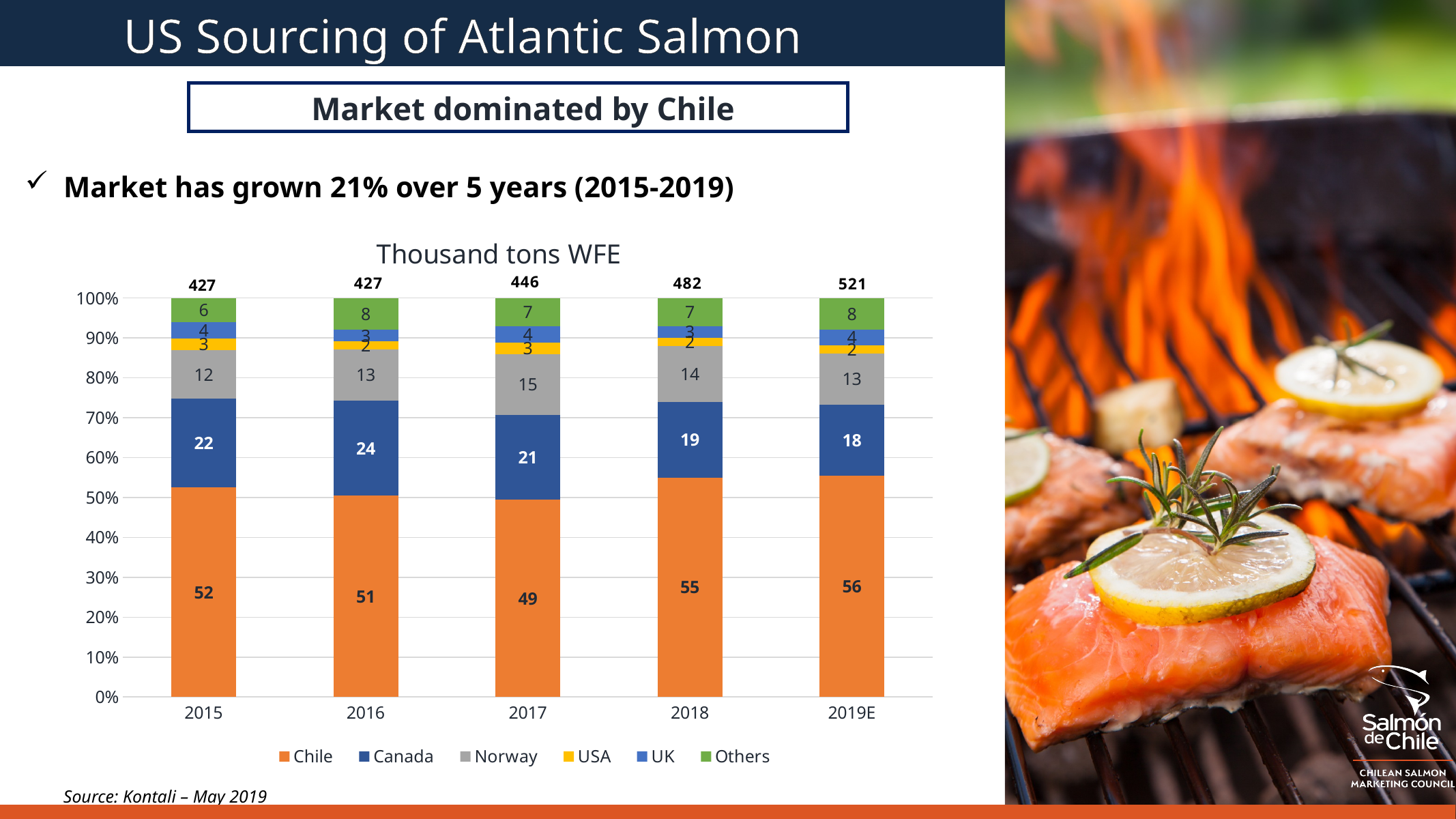
Does the Canada data label rise or fall from 2016 to 2019E? Fall What is the data label for Chile in 2017? 49 What is the data label for Norway in 2017? 15 What kind of chart is shown? Stacked bar chart How many years are shown on the x axis? 5 What is the title of the chart? Thousand tons WFE Which is larger, the Canada data label in 2016 or in 2018? 2016 How many series does the legend list? 6 What is the difference between the totals printed above the 2019E and 2015 bars? 94 Which year has the highest total printed above its bar? 2019E In which year is the Chile data label lowest? 2017 What total is printed above the 2019E bar? 521